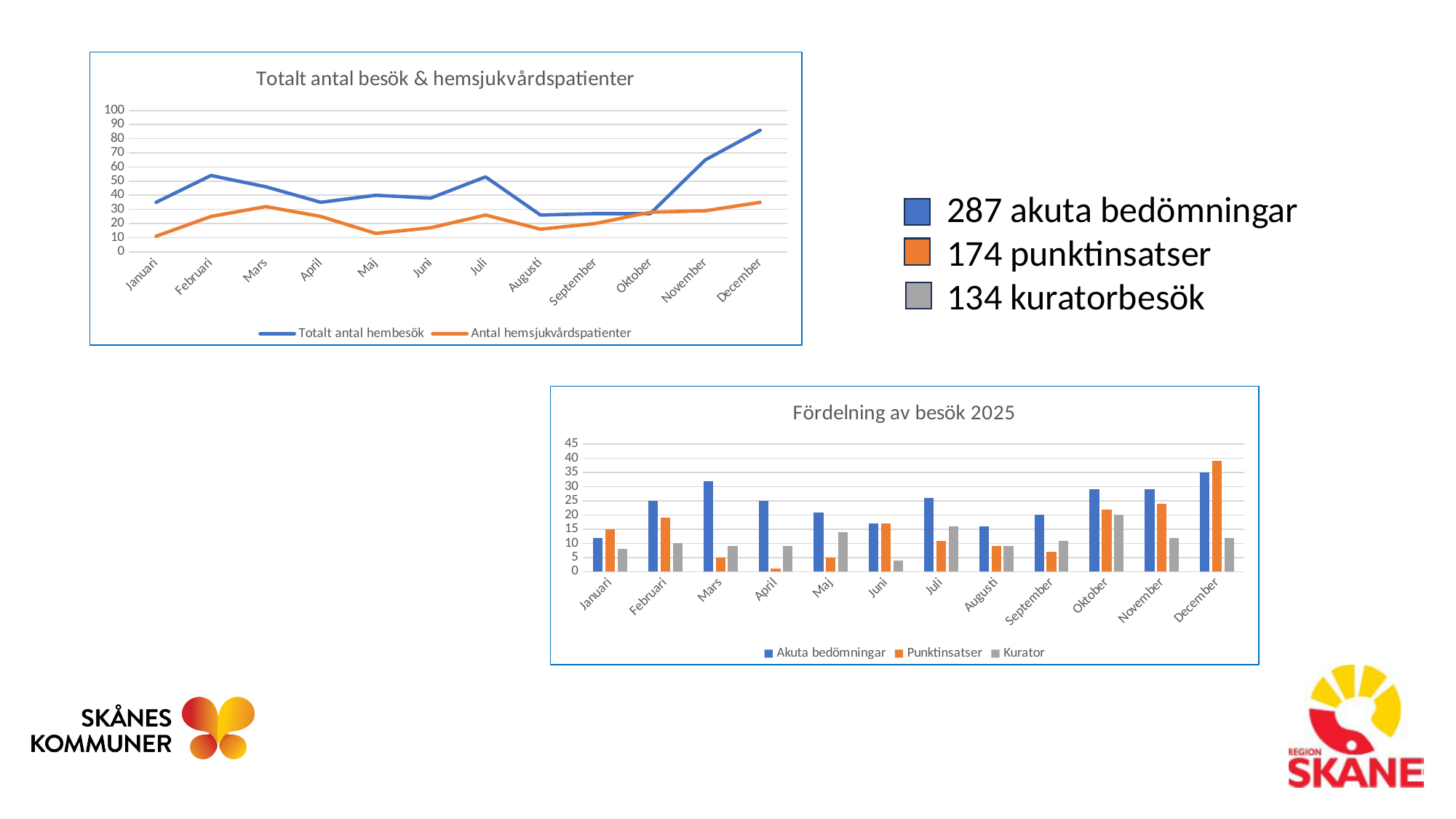
In the chart 'Fördelning av besök 2025', in which month is Punktinsatser lowest? April In the chart 'Fördelning av besök 2025', for Mars, which is larger: Akuta bedömningar or Punktinsatser? Akuta bedömningar In the chart 'Fördelning av besök 2025', in which month is Kurator highest? Oktober What kind of chart is the chart titled 'Fördelning av besök 2025'? bar chart What kind of chart is the chart titled 'Totalt antal besök & hemsjukvårdspatienter'? line chart In the chart 'Fördelning av besök 2025', in which month is Punktinsatser highest? December In the chart 'Totalt antal besök & hemsjukvårdspatienter', in which month is Totalt antal hembesök highest? December In the chart 'Totalt antal besök & hemsjukvårdspatienter', how many series does the legend list? 2 In the chart 'Fördelning av besök 2025', how many series does the legend list? 3 In the chart 'Totalt antal besök & hemsjukvårdspatienter', is the value of Antal hemsjukvårdspatienter for Januari greater or less than 20? less In the chart 'Totalt antal besök & hemsjukvårdspatienter', is the value of Totalt antal hembesök for December greater or less than 80? greater In the chart 'Fördelning av besök 2025', how many months are shown on the x axis? 12